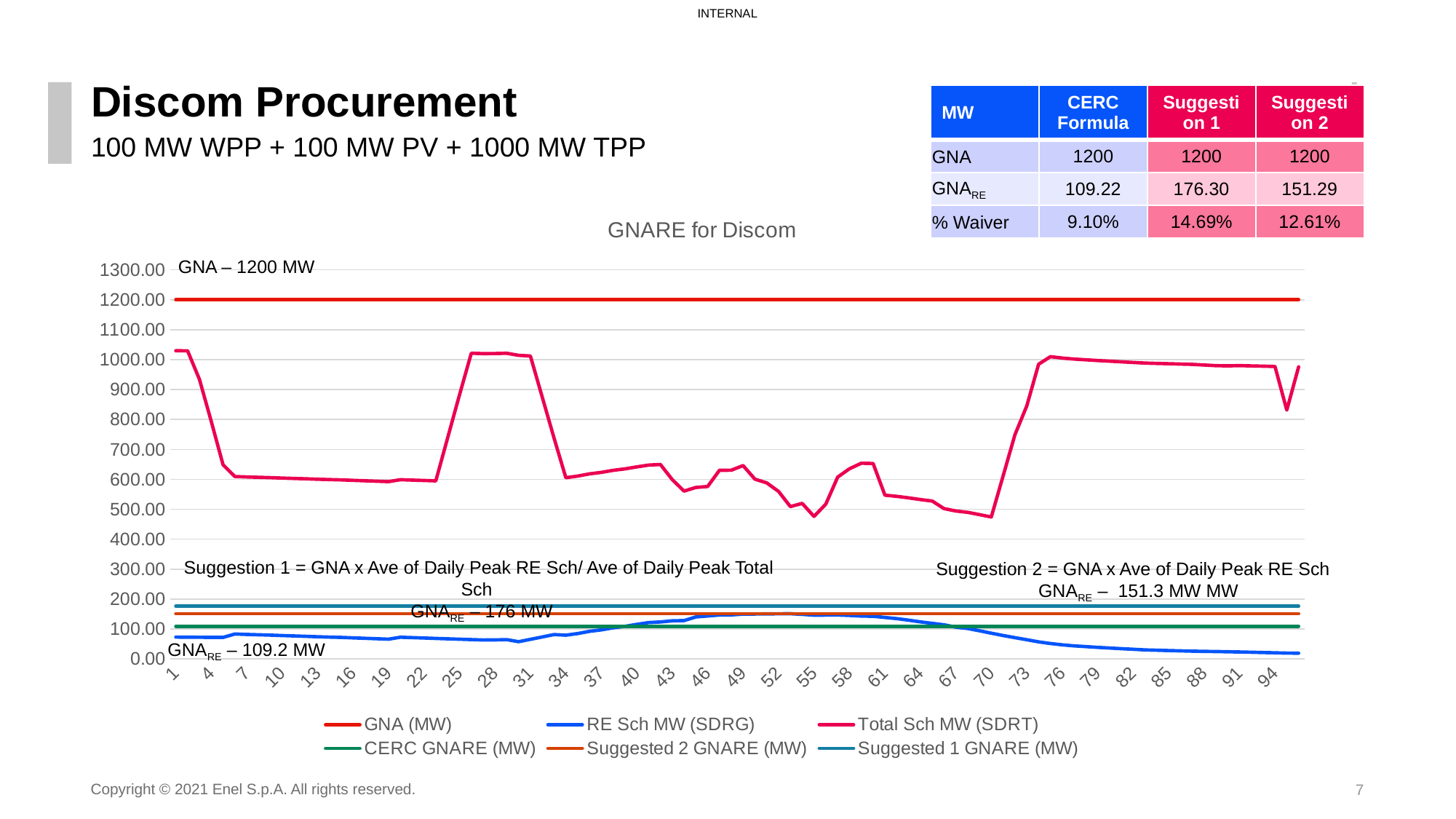
What is the title of the chart? GNARE for Discom What value is labelled for the CERC GNARE (MW) line? 109.2 MW Does the RE Sch MW (SDRG) line rise or fall between x = 73 and x = 94? fall What value is labelled for the Suggested 2 GNARE (MW) line? 151.3 MW What is the difference between the labelled Suggested 1 GNARE value and the labelled CERC GNARE value? 66.8 MW How many series does the chart legend list? 6 Is the value of RE Sch MW (SDRG) at x = 49 greater or less than 100? greater What value is labelled for the Suggested 1 GNARE (MW) line? 176 MW What kind of chart is shown on the slide? line chart What value does the GNA (MW) line sit at, according to the label on the chart? 1200 MW Which is higher, the Suggested 1 GNARE (MW) line or the Suggested 2 GNARE (MW) line? Suggested 1 GNARE (MW) Is the value of Total Sch MW (SDRT) at x = 13 greater or less than 700? less